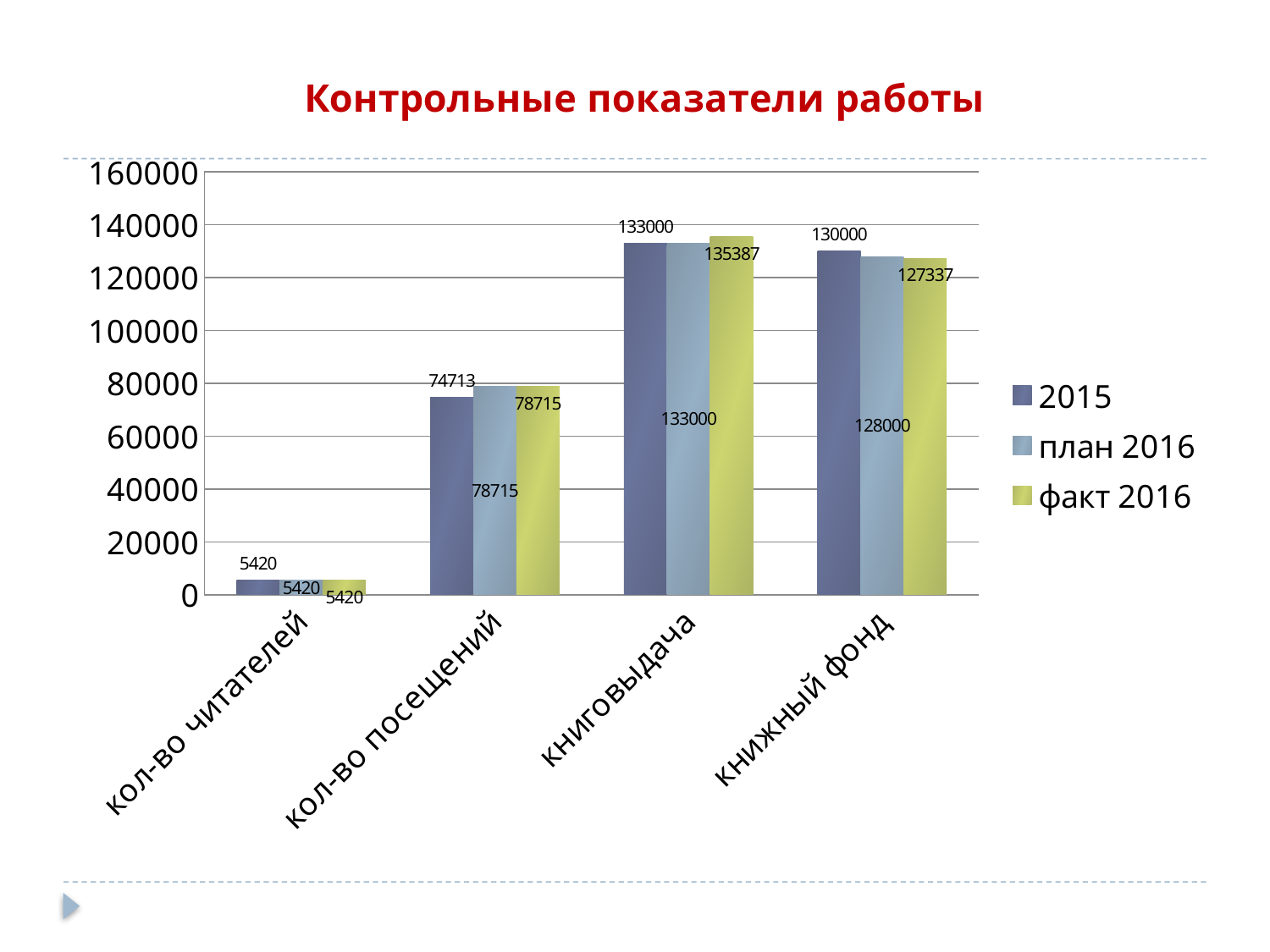
What is the difference between the план 2016 and 2015 values for кол-во посещений? 4002 What is the difference between the 2015 and факт 2016 values for книжный фонд? 2663 What is the value for кол-во читателей in the факт 2016 series? 5420 For книжный фонд, which is larger: the 2015 value or the факт 2016 value? 2015 Which category has the highest value in the факт 2016 series? книговыдача What kind of chart is shown on the slide? bar chart What is the value for книжный фонд in the план 2016 series? 128000 What is the value for кол-во посещений in the 2015 series? 74713 Which category has the lowest value in the 2015 series? кол-во читателей How many series does the legend list? 3 What is the value for книговыдача in the факт 2016 series? 135387 How many categories are shown on the x axis? 4